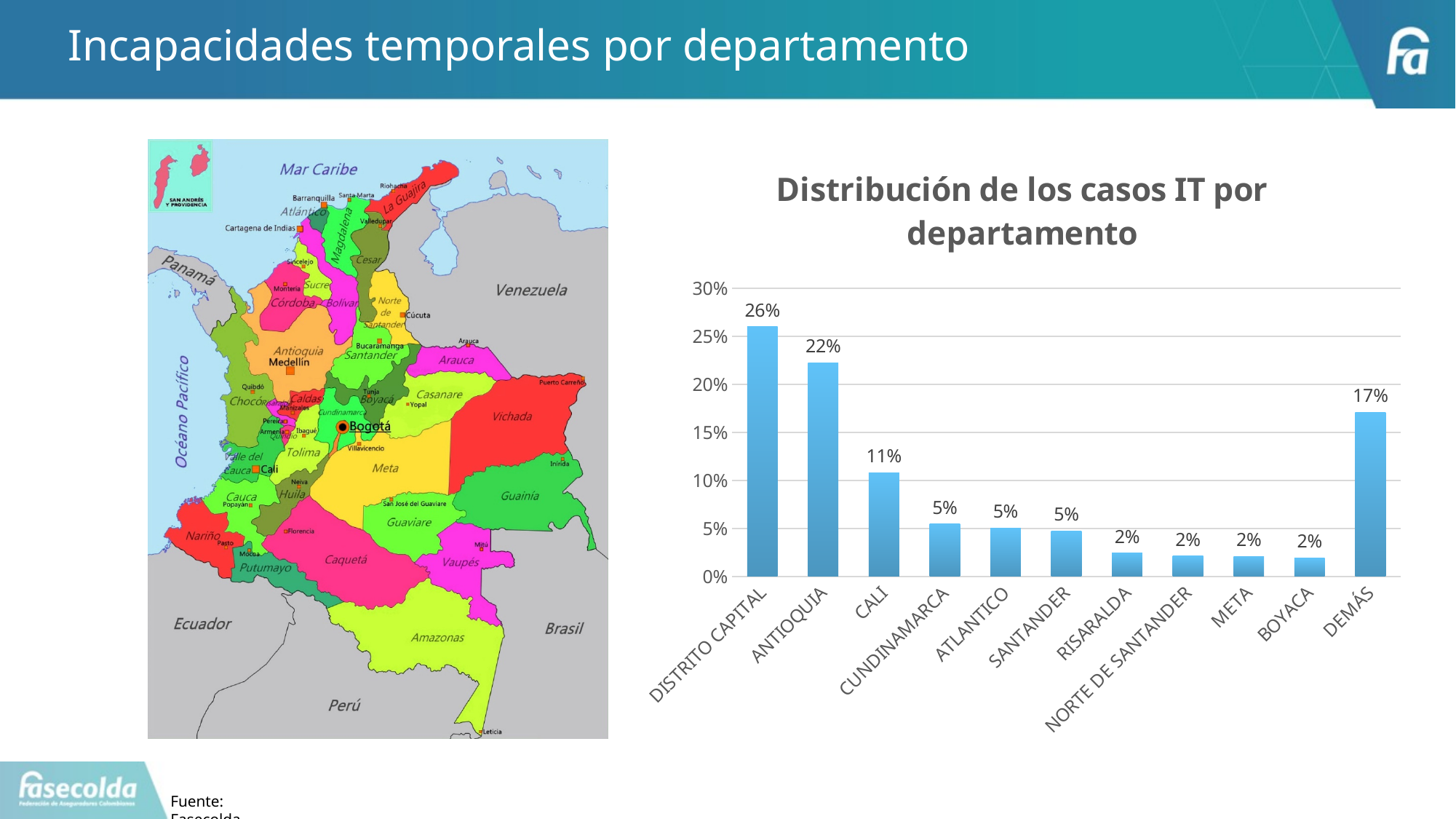
How many categories are shown on the x axis? 11 What kind of chart is shown on the slide? bar chart What is the value for DEMÁS? 17% What is the value for ANTIOQUIA? 22% What is the value for DISTRITO CAPITAL? 26% Which category has the highest value? DISTRITO CAPITAL What is the title of the chart? Distribución de los casos IT por departamento What is the difference between the values for DISTRITO CAPITAL and ANTIOQUIA? 4% Is the value for ANTIOQUIA greater or less than 20%? greater Which is larger, the value for CALI or the value for DEMÁS? DEMÁS What is the value for CALI? 11% What is the value for RISARALDA? 2%